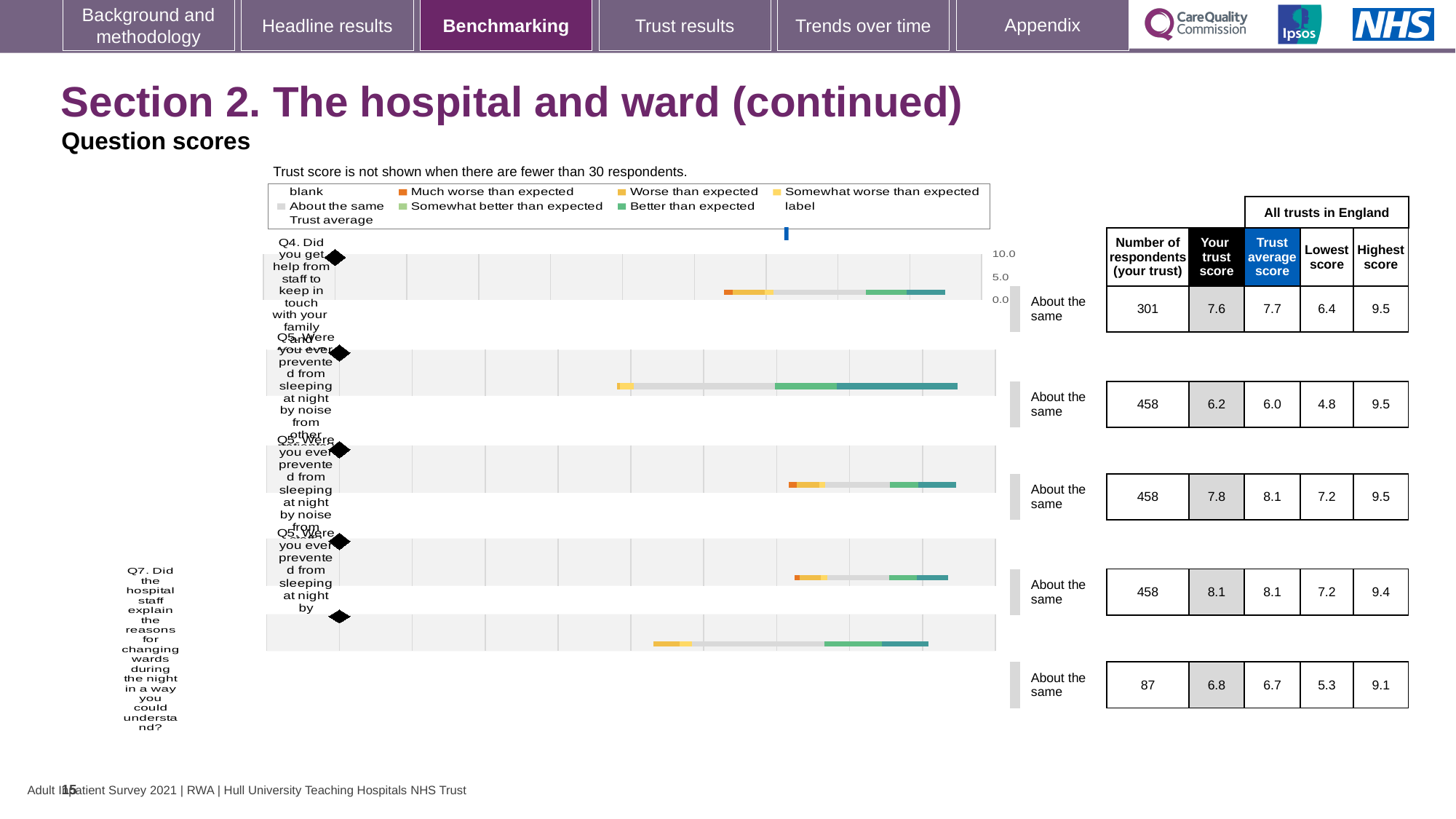
According to the table beside the chart, what is the trust score for Q7 (explaining reasons for changing wards during the night)? 6.8 Which has the higher trust score in the table: Q4 or Q7? Q4 According to the table beside the chart, how many respondents answered Q4? 301 How many question rows (bars) are plotted in the benchmarking chart? 5 What kind of chart is used to show the question scores on this slide? bar chart What is the highest value shown on the chart's score axis? 10.0 What benchmark category is shown next to every bar in the chart? About the same Is the trust score for Q7 greater or less than 5.0 on the chart axis? greater According to the table beside the chart, how many respondents answered Q7? 87 What is the difference between the trust score and the trust average score for Q4 in the table? 0.1 Which legend entry is shown in dark orange in the chart legend? Much worse than expected According to the table beside the chart, what is the trust score for Q4 (help from staff to keep in touch with family)? 7.6